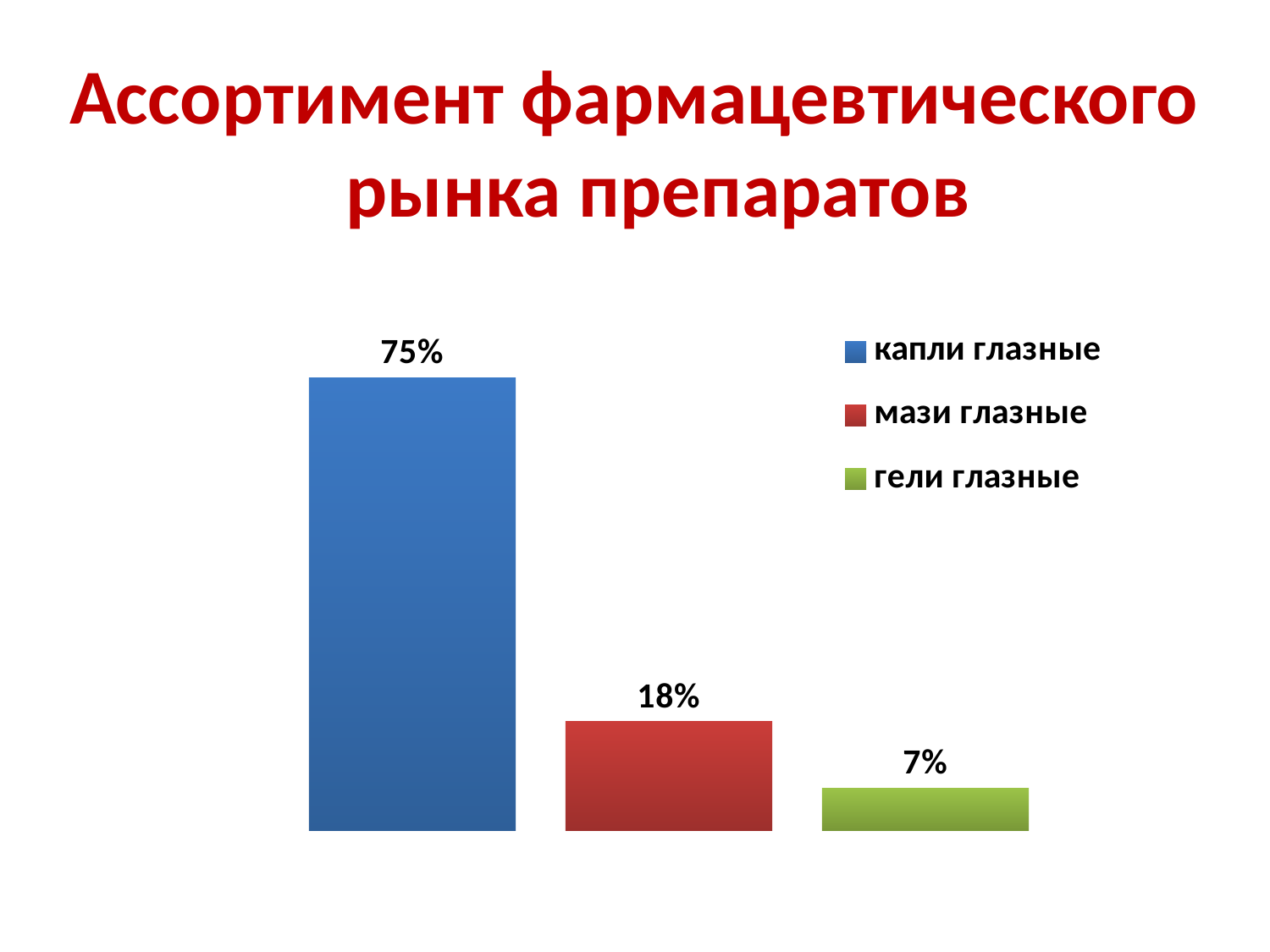
How many entries does the legend list? 3 Which is larger, the value for мази глазные or the value for гели глазные? мази глазные What kind of chart is shown on the slide? bar chart What is the value for мази глазные? 18% Which category has the highest value? капли глазные What is the value for капли глазные? 75% What is the difference between the values for мази глазные and гели глазные? 11% What colour is the bar for мази глазные? red How many bars are plotted on the chart? 3 What is the value for гели глазные? 7% What is the difference between the values for капли глазные and мази глазные? 57% Which category has the lowest value? гели глазные